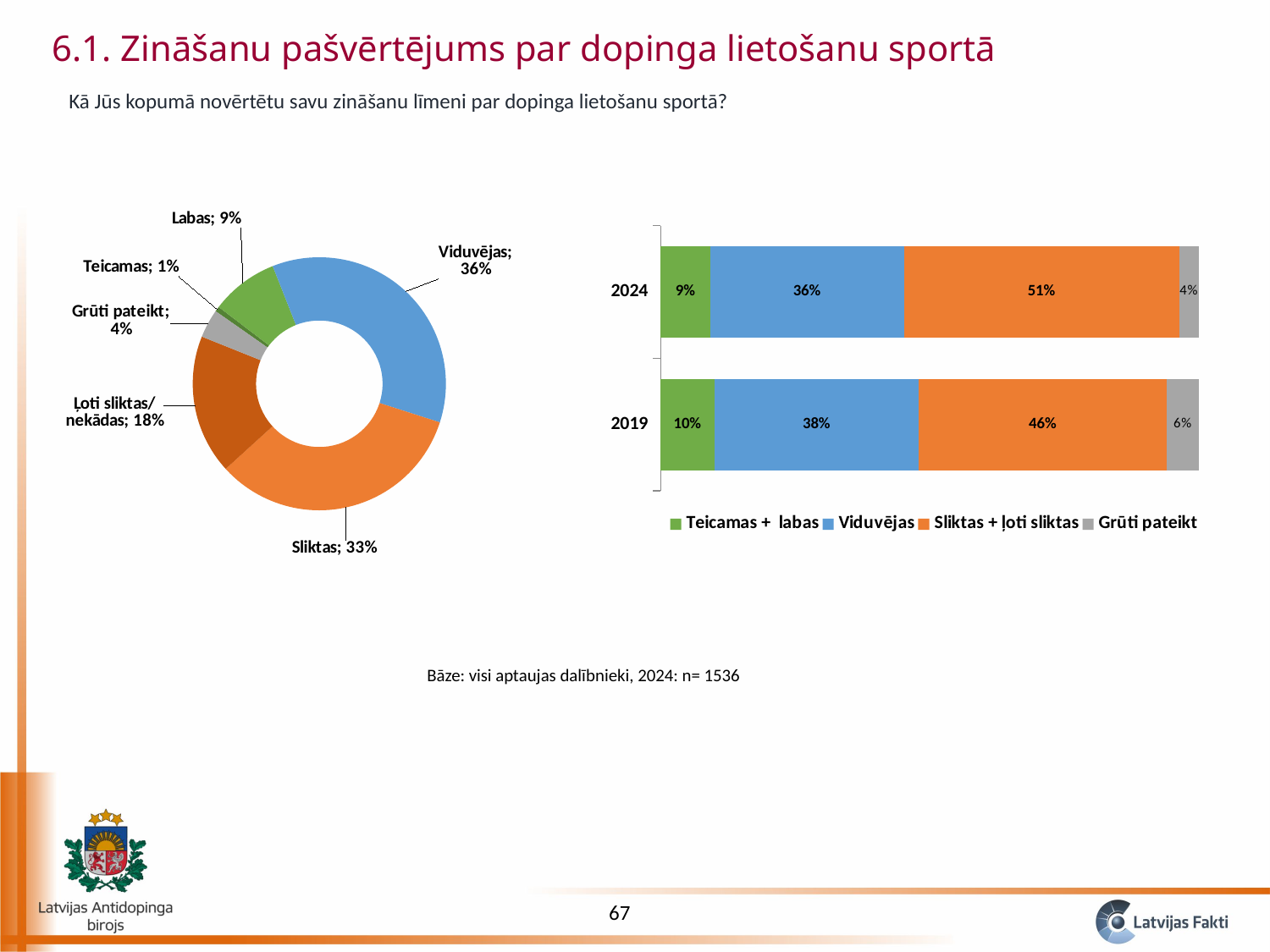
In the stacked bar chart on the right, what is the difference between the "Sliktas + ļoti sliktas" values for 2024 and 2019? 5% In the stacked bar chart on the right, what is the value for "Viduvējas" in 2019? 38% In the stacked bar chart on the right, what is the value for "Sliktas + ļoti sliktas" in 2024? 51% In the stacked bar chart on the right, which year has the larger value for "Grūti pateikt", 2024 or 2019? 2019 How many series does the legend of the stacked bar chart on the right list? 4 In the doughnut chart on the left, what share is labelled "Ļoti sliktas/ nekādas"? 18% In the doughnut chart on the left, which category has the largest share? Viduvējas What type of chart is shown on the right side of the slide? Stacked bar chart In the doughnut chart on the left, what share is labelled "Viduvējas"? 36% How many slices does the doughnut chart on the left have? 6 In the doughnut chart on the left, what is the difference between the "Sliktas" share and the "Labas" share? 24% In the doughnut chart on the left, which category has the smallest share? Teicamas